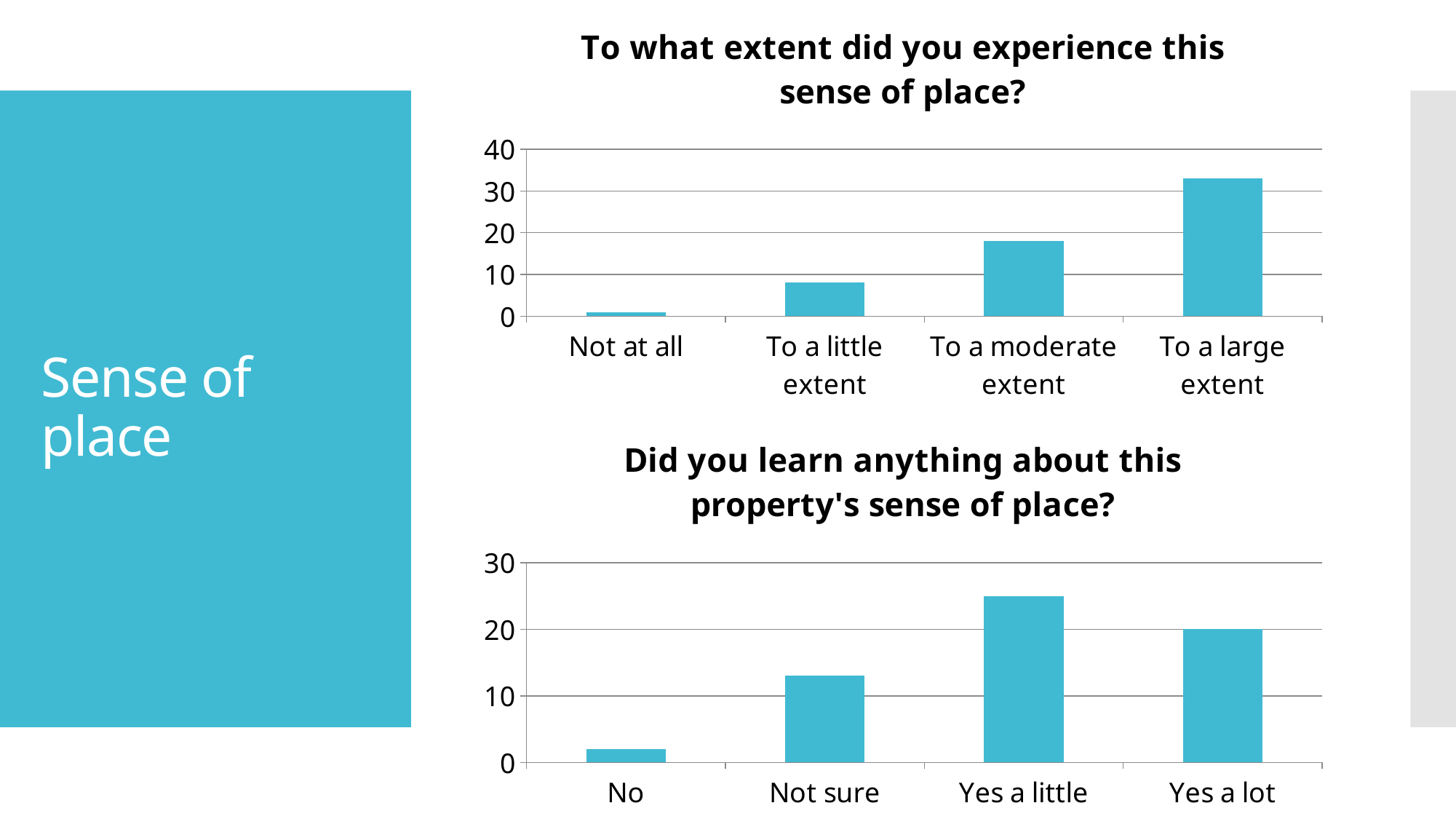
In the top chart "To what extent did you experience this sense of place?", which category has the highest value? To a large extent In the bottom chart "Did you learn anything about this property's sense of place?", which category has the lowest value? No In the bottom chart "Did you learn anything about this property's sense of place?", which is larger, the value for "Yes a little" or the value for "Yes a lot"? Yes a little In the top chart "To what extent did you experience this sense of place?", how many categories are shown on the x axis? 4 What kind of chart is the top chart titled "To what extent did you experience this sense of place?"? bar chart In the top chart "To what extent did you experience this sense of place?", do the values rise or fall from left to right along the x axis? rise In the top chart "To what extent did you experience this sense of place?", is the value for "To a moderate extent" greater or less than 20? less How many charts are shown on the slide? 2 In the bottom chart "Did you learn anything about this property's sense of place?", which category has the highest value? Yes a little In the top chart "To what extent did you experience this sense of place?", which category has the lowest value? Not at all In the top chart "To what extent did you experience this sense of place?", is the value for "To a large extent" greater or less than 30? greater In the bottom chart "Did you learn anything about this property's sense of place?", is the value for "Not sure" greater or less than 10? greater